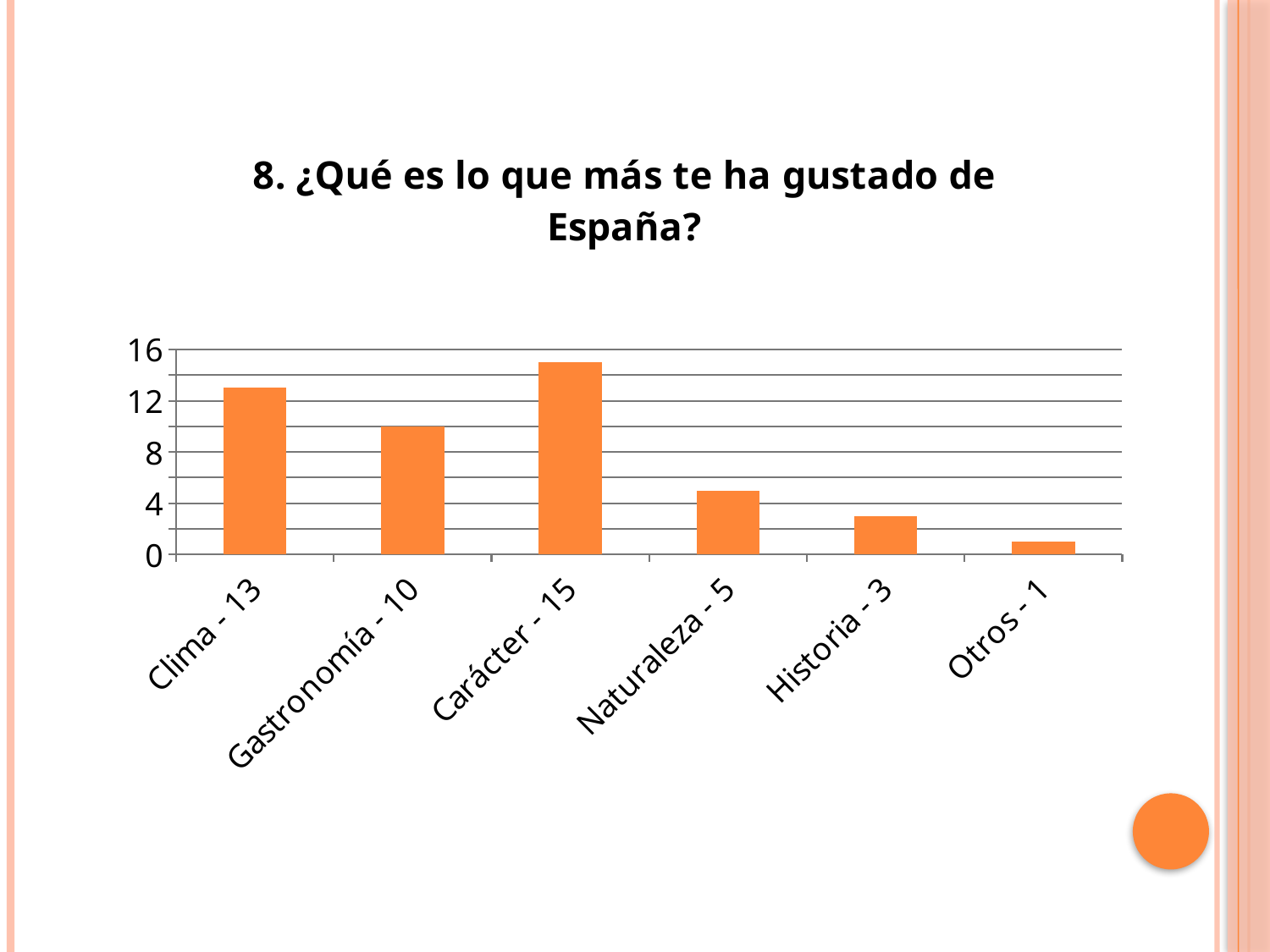
What kind of chart is shown on the slide? bar chart What is the value for Naturaleza? 5 What is the title of the chart? 8. ¿Qué es lo que más te ha gustado de España? What colour are the bars in the chart? orange What is the difference between the values for Carácter and Historia? 12 How many categories are shown in the chart? 6 Which is larger, the value for Clima or the value for Gastronomía? Clima Is the value for Carácter greater or less than 12? greater Which category has the highest value? Carácter What is the value for Clima? 13 Which category has the lowest value? Otros What is the value for Gastronomía? 10